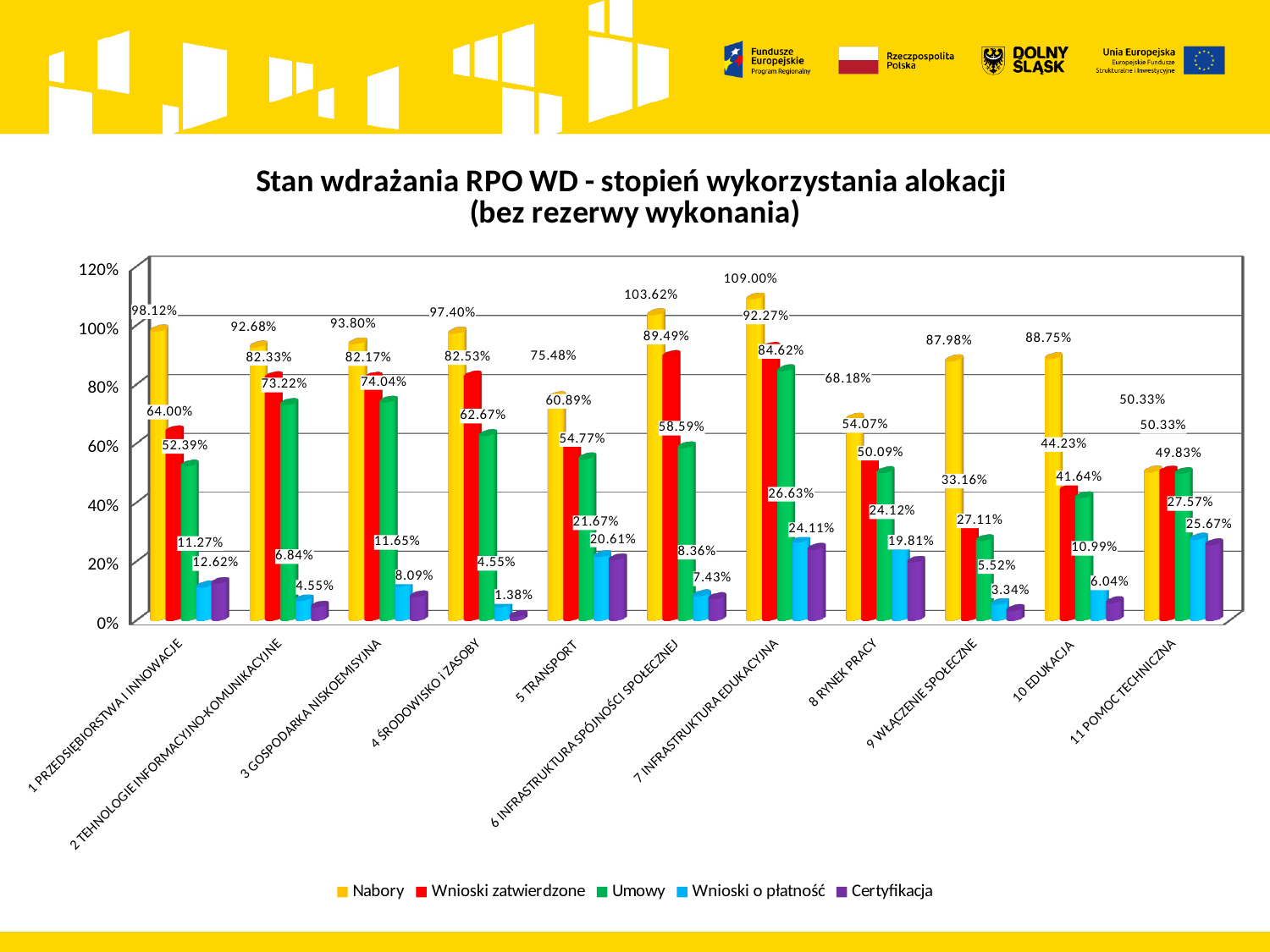
What is the Nabory value for 5 TRANSPORT? 75.48% Which is larger: the Umowy value for 7 INFRASTRUKTURA EDUKACYJNA or for 8 RYNEK PRACY? 7 INFRASTRUKTURA EDUKACYJNA Is the Nabory value for 8 RYNEK PRACY greater or less than 60%? greater What colour represents the Nabory series in the legend? yellow What is the Wnioski zatwierdzone value for 9 WŁĄCZENIE SPOŁECZNE? 33.16% Which category has the lowest Nabory value? 11 POMOC TECHNICZNA How many series does the legend list? 5 Which category has the highest Nabory value? 7 INFRASTRUKTURA EDUKACYJNA What is the difference between the Nabory values for 7 INFRASTRUKTURA EDUKACYJNA and 6 INFRASTRUKTURA SPÓJNOŚCI SPOŁECZNEJ? 5.38% What is the Certyfikacja value for 4 ŚRODOWISKO I ZASOBY? 1.38% What kind of chart is shown on the slide? bar chart How many categories (priority axes) are shown on the x axis? 11